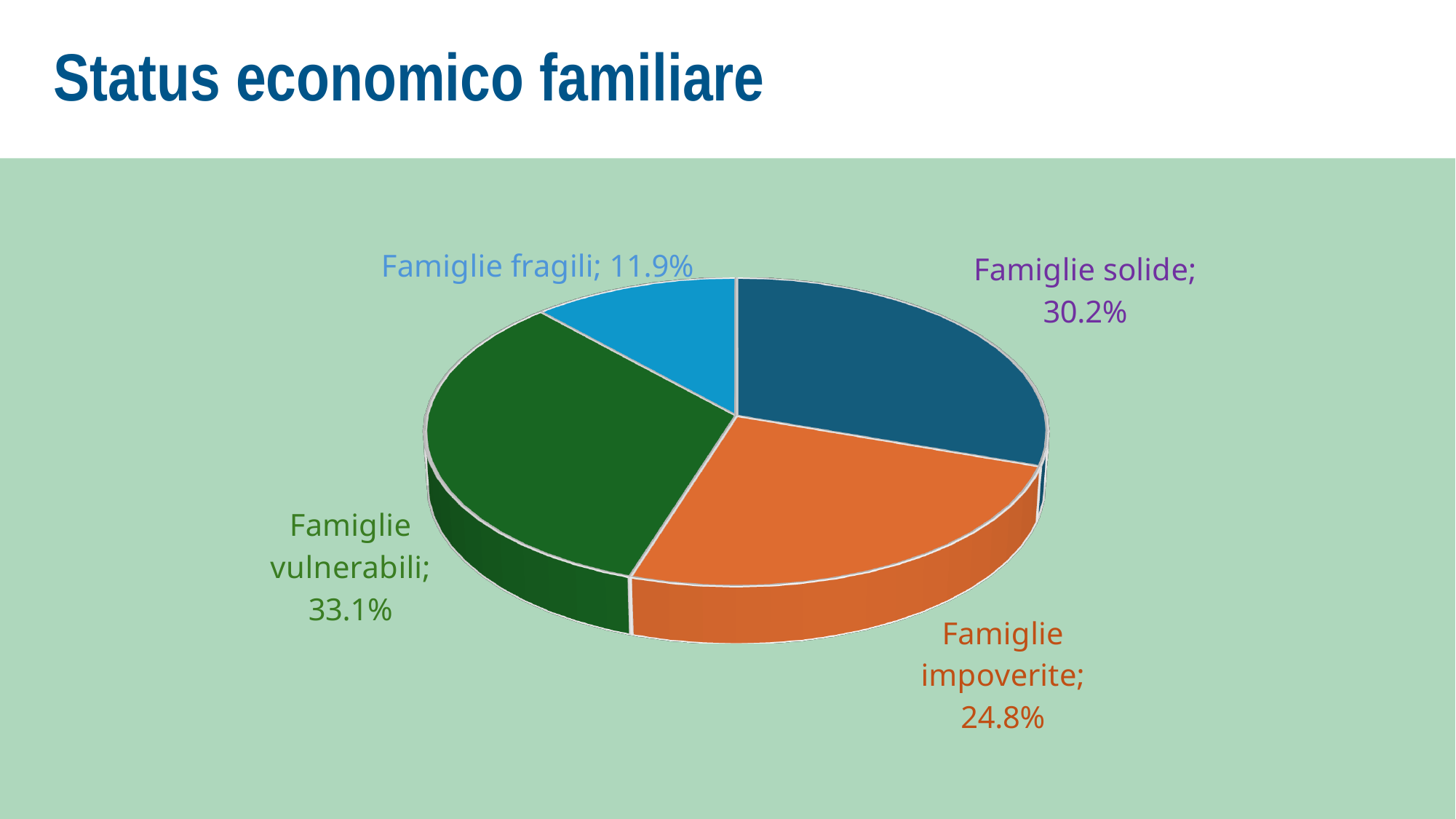
What type of chart is shown on the slide? pie chart What is the value for Famiglie solide? 30.2% What is the title of the slide? Status economico familiare How many categories does the pie chart show? 4 Which category has the largest share of the pie? Famiglie vulnerabili What is the difference between the values for Famiglie solide and Famiglie impoverite? 5.4% What is the value for Famiglie impoverite? 24.8% Which category has the smallest share of the pie? Famiglie fragili What is the difference between the values for Famiglie vulnerabili and Famiglie fragili? 21.2% What is the value for Famiglie vulnerabili? 33.1% Which is larger, Famiglie solide or Famiglie impoverite? Famiglie solide What is the value for Famiglie fragili? 11.9%